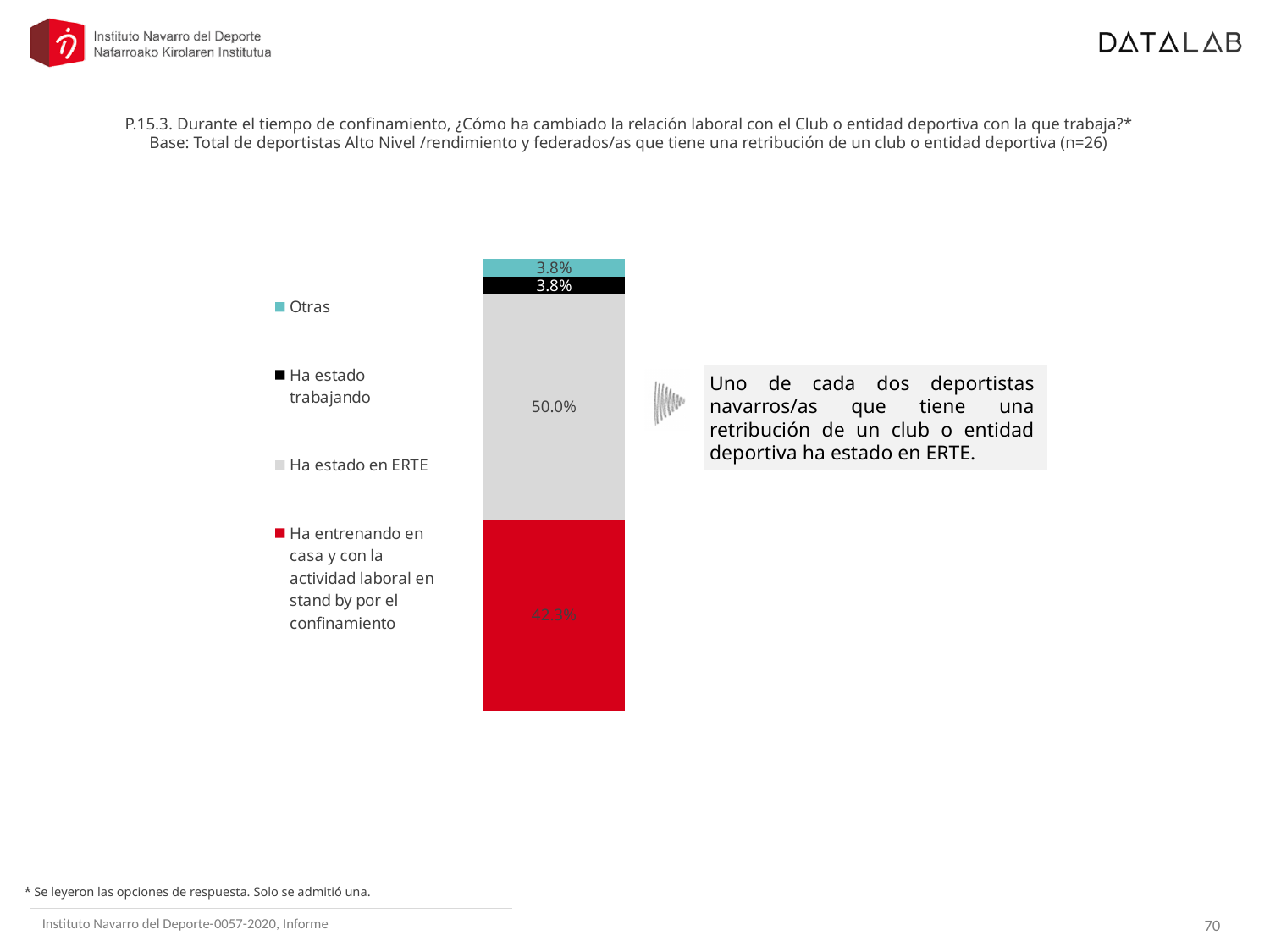
What is the sample size (n) stated in the chart's base description? n=26 What kind of chart is shown on the slide? Stacked bar chart What percentage is shown for the 'Otras' category? 3.8% What percentage of athletes 'Ha entrenando en casa y con la actividad laboral en stand by por el confinamiento'? 42.3% How many categories does the legend list? 4 What is the difference between the 'Ha estado en ERTE' share and the 'Ha estado trabajando' share? 46.2 percentage points What colour is the segment for 'Ha estado en ERTE'? Grey What percentage of athletes 'Ha estado trabajando'? 3.8% What is the total of the stacked bar? 99.9% Which category has the largest share in the stacked bar? Ha estado en ERTE Which is larger: the share for 'Ha estado en ERTE' or the share for 'Ha entrenando en casa y con la actividad laboral en stand by por el confinamiento'? Ha estado en ERTE What percentage of athletes 'Ha estado en ERTE'? 50.0%